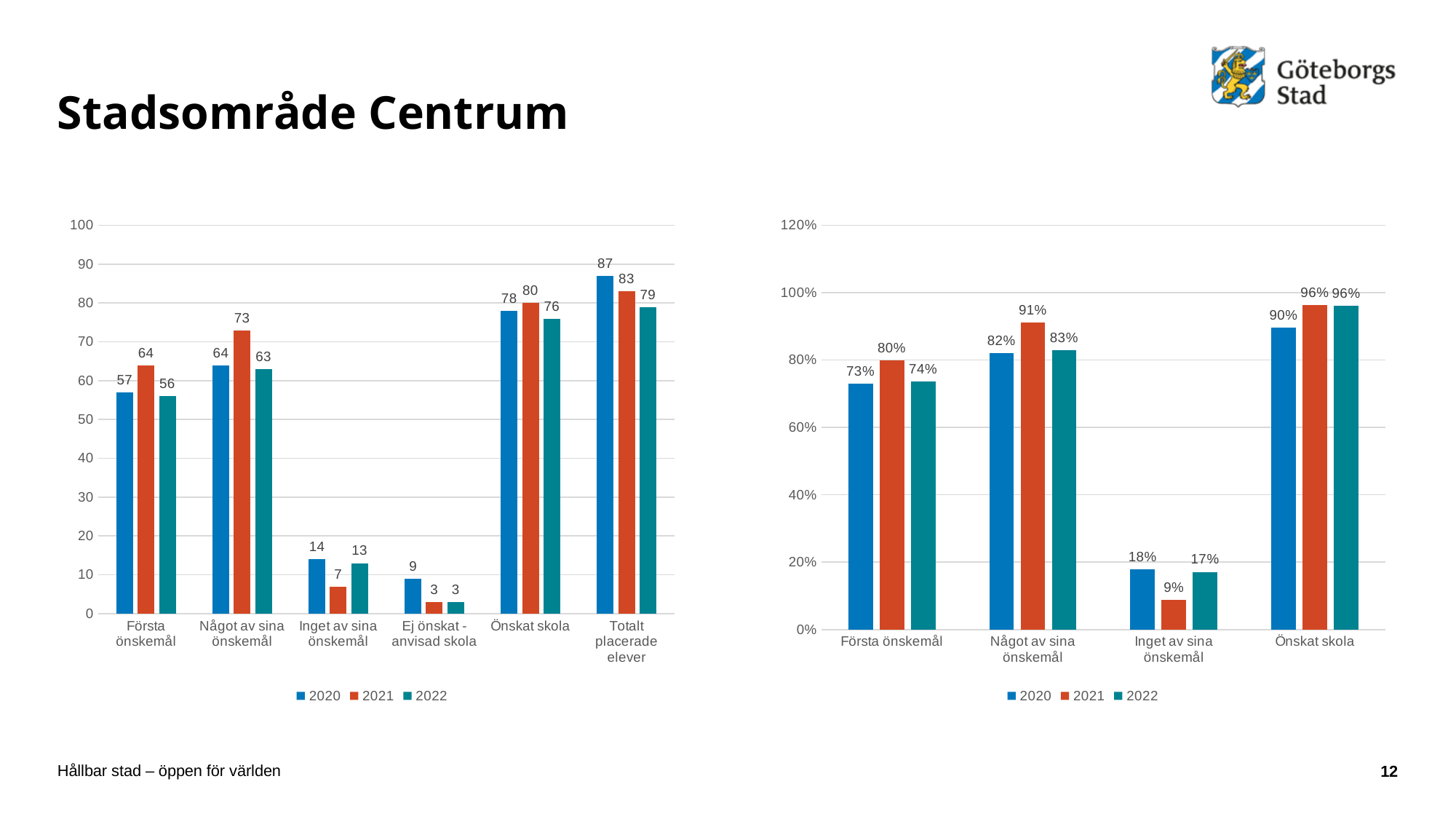
In the left chart, which category has the highest value for 2022? Totalt placerade elever In the right chart, what is the value for 2022 in the 'Något av sina önskemål' category? 83% How many series does the legend of the left chart list? 3 In the left chart, which is larger for 'Inget av sina önskemål': the 2020 value or the 2022 value? 2020 How many categories are shown on the x axis of the right chart? 4 In the left chart, what is the value for 2021 in the 'Första önskemål' category? 64 What kind of chart is the right chart? Bar chart In the right chart, what is the value for 2021 in the 'Inget av sina önskemål' category? 9% In the right chart, what is the difference between the 2021 and 2020 values for 'Första önskemål'? 7% In the right chart, which category has the lowest value for 2020? Inget av sina önskemål In the left chart, what is the difference between the 2021 and 2020 values for 'Något av sina önskemål'? 9 In the left chart, what is the value for 2020 in the 'Totalt placerade elever' category? 87